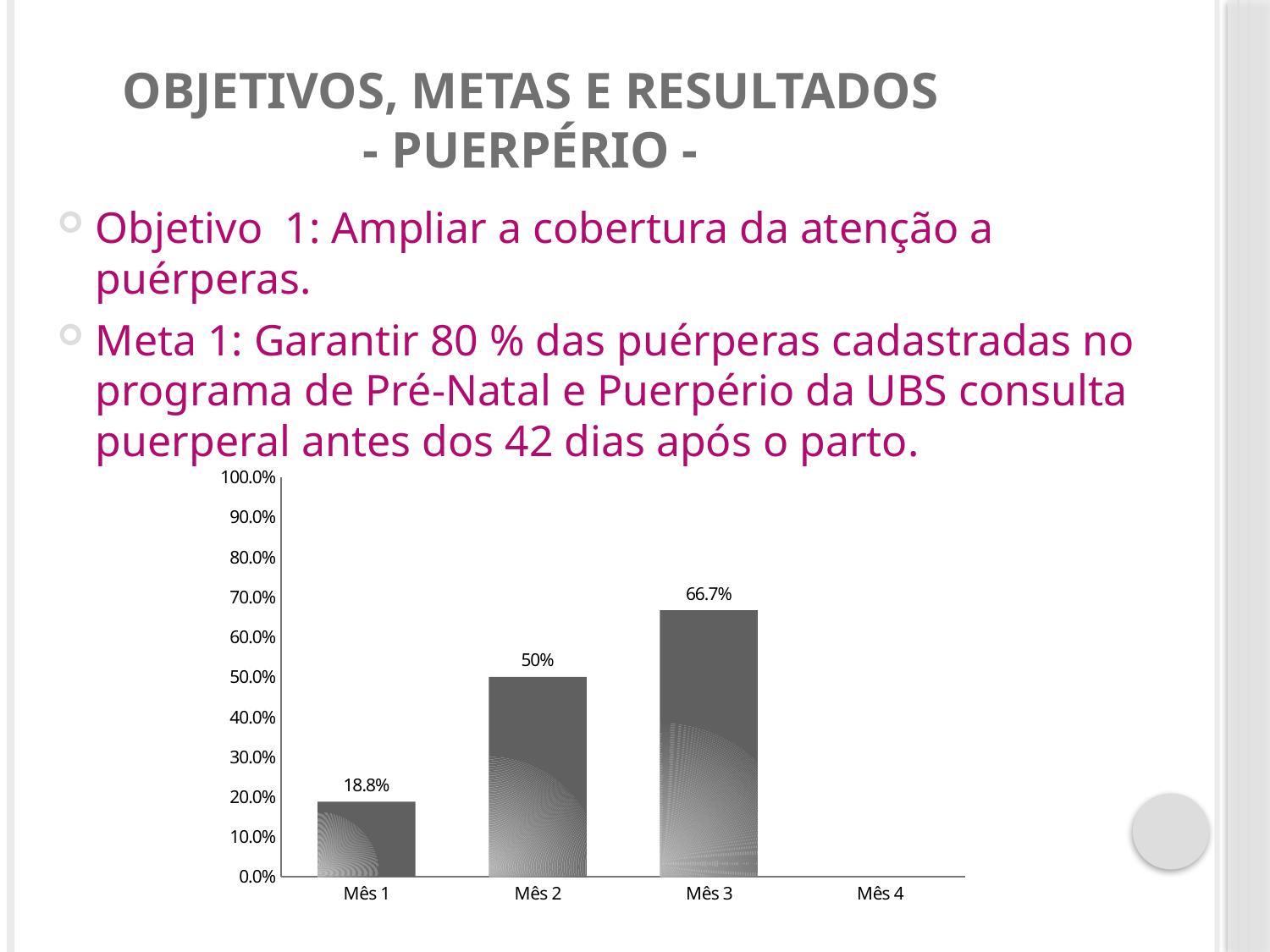
Do the values rise or fall from Mês 1 to Mês 3? Rise What is the value shown for Mês 3? 66.7% What is the value shown for Mês 2? 50% Among the months with a bar, which has the lowest value? Mês 1 Which is larger, the value for Mês 2 or the value for Mês 1? Mês 2 Is the value for Mês 3 greater or less than 60.0%? greater What is the value shown for Mês 1? 18.8% What is the difference between the values for Mês 3 and Mês 2? 16.7 percentage points What kind of chart is shown on the slide? Bar chart What is the difference between the values for Mês 2 and Mês 1? 31.2 percentage points Which month has the highest value in the chart? Mês 3 How many categories are labelled on the x axis of the chart? 4